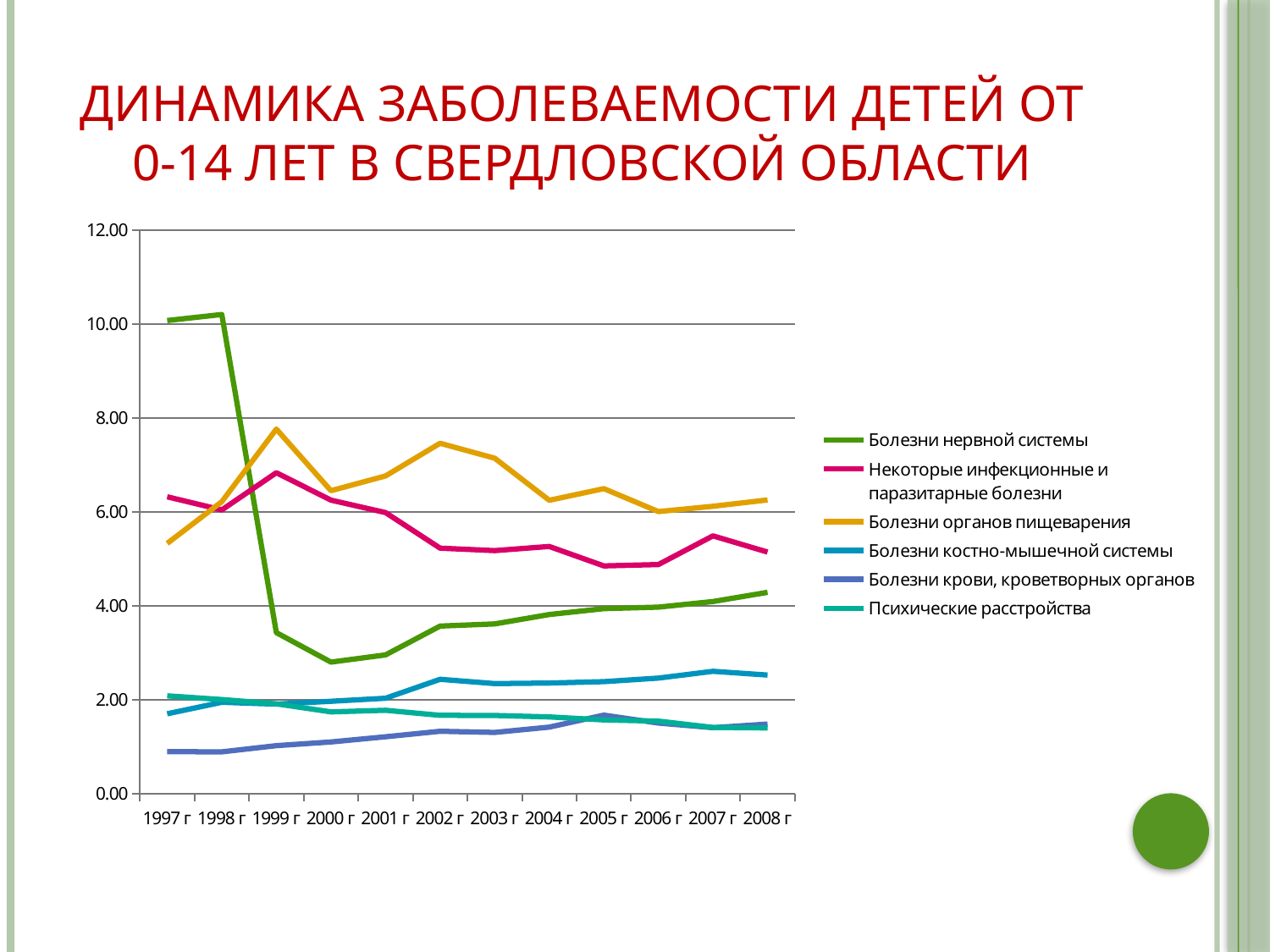
How many series does the legend list? 6 Which series has the highest value in 2008 г? Болезни органов пищеварения How many years are shown along the x axis? 12 Does the value for Болезни нервной системы rise or fall between 1998 г and 1999 г? fall Which series has the highest value in 1997 г? Болезни нервной системы What kind of chart is shown on the slide? line chart Is the value for Болезни крови, кроветворных органов in 1997 г greater or less than 2.00? less Is the value for Болезни костно-мышечной системы in 2007 г greater or less than 2.00? greater Is the value for Болезни нервной системы in 1997 г greater or less than 8.00? greater In 2002 г, which is larger: Болезни органов пищеварения or Некоторые инфекционные и паразитарные болезни? Болезни органов пищеварения In which year does Болезни нервной системы reach its lowest value? 2000 г Which series has the lowest value in 1997 г? Болезни крови, кроветворных органов